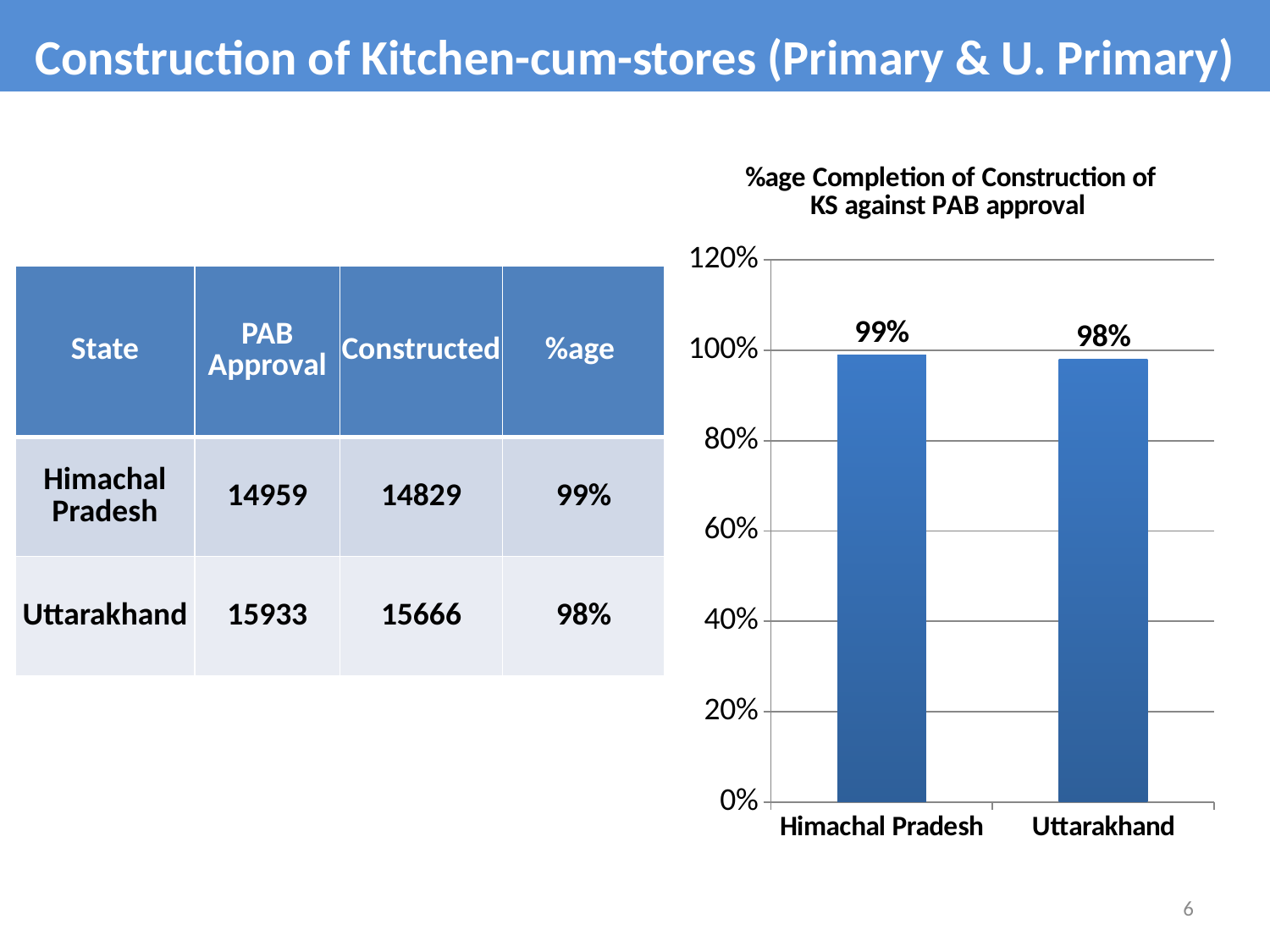
Is the value for Himachal Pradesh greater or less than 100%? less What is the title of the chart? %age Completion of Construction of KS against PAB approval Is the value for Uttarakhand greater or less than 80%? greater What kind of chart is shown on the slide? Bar chart Do the values rise or fall from Himachal Pradesh to Uttarakhand along the x axis? Fall Which state has the lowest value in the chart? Uttarakhand What is the value for Uttarakhand in the chart? 98% How many states are shown in the chart? 2 What is the difference between the values for Himachal Pradesh and Uttarakhand in the chart? 1% Which state has the highest value in the chart? Himachal Pradesh What is the highest value shown on the chart's y axis? 120% What is the value for Himachal Pradesh in the chart? 99%